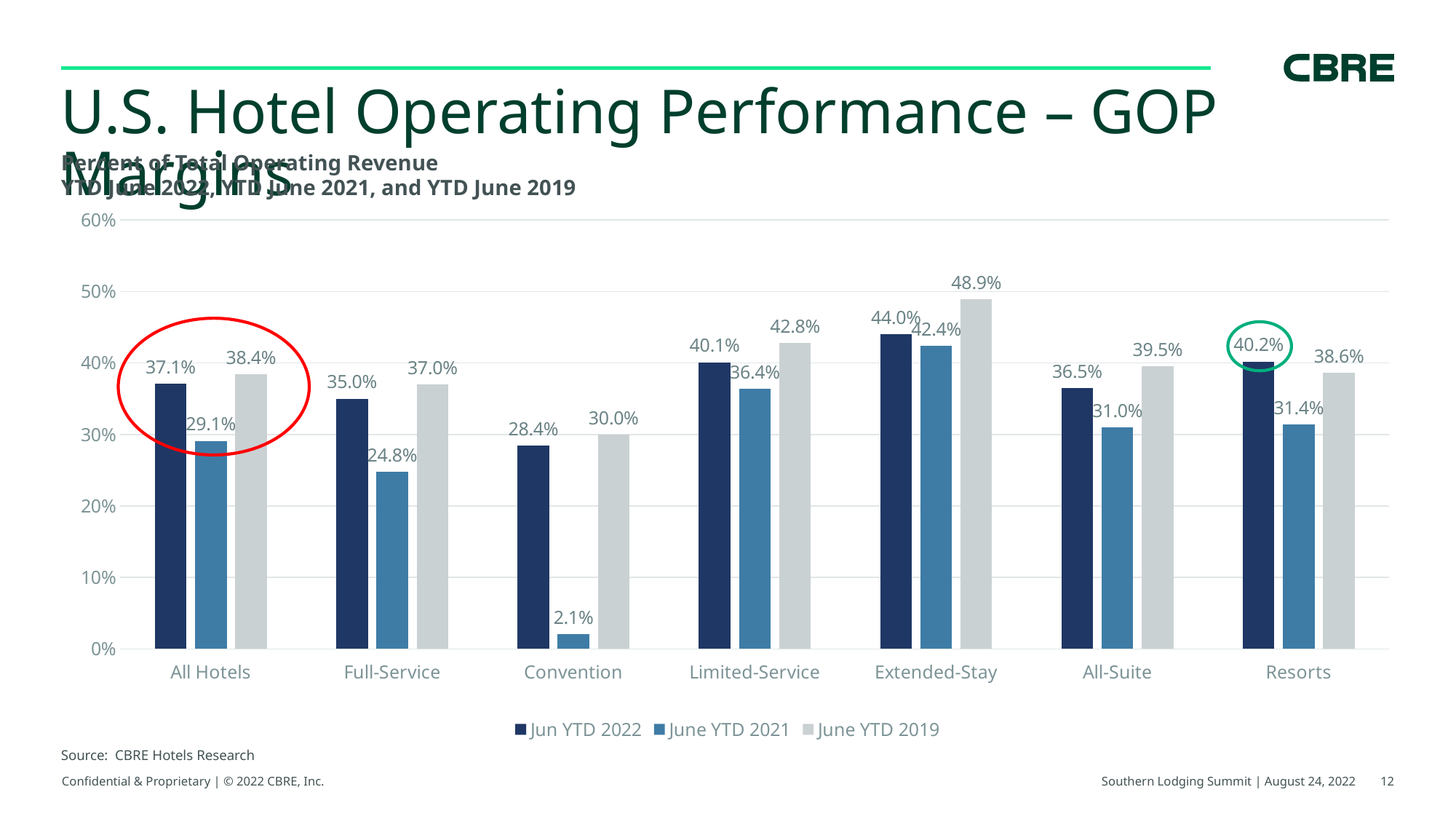
How many hotel categories are shown on the x axis? 7 For Resorts, which is larger: the Jun YTD 2022 value or the June YTD 2019 value? Jun YTD 2022 What kind of chart is shown on the slide? bar chart Which category is circled in red on the chart? All Hotels Which category has the highest Jun YTD 2022 value? Extended-Stay What is the Jun YTD 2022 value for All Hotels? 37.1% How many series does the legend list? 3 Which category has the lowest June YTD 2021 value? Convention What is the June YTD 2021 value for Convention? 2.1% What is the June YTD 2019 value for Extended-Stay? 48.9% Is the June YTD 2021 value for Full-Service greater or less than 30%? less What is the difference between the June YTD 2019 and June YTD 2021 values for All Hotels? 9.3%